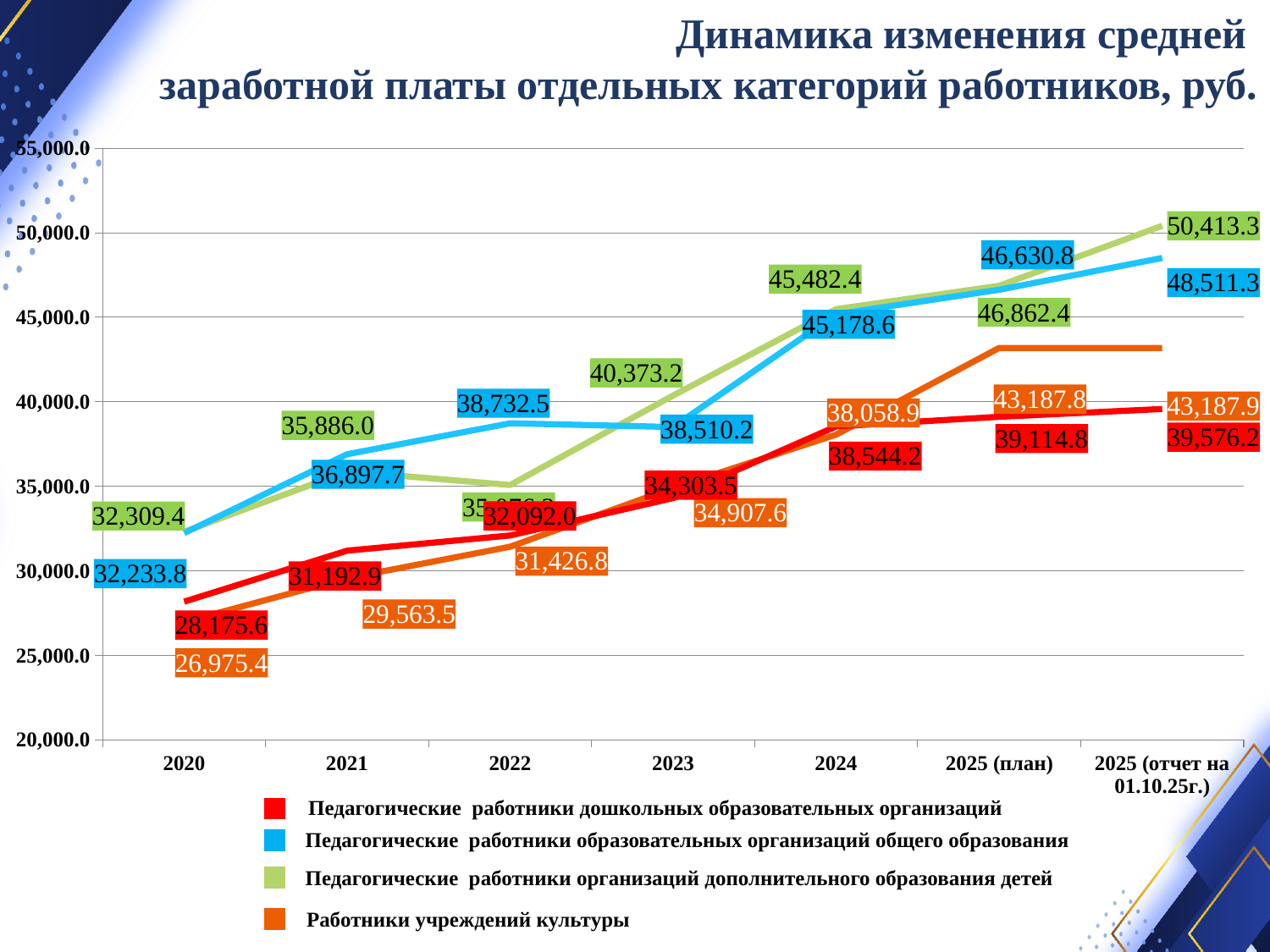
What kind of chart is shown on the slide? Line chart How many categories are shown along the x axis? 7 What is the difference between the values for Педагогические работники организаций дополнительного образования детей and Педагогические работники образовательных организаций общего образования in 2025 (отчет на 01.10.25г.)? 1,902.0 Which series has the highest value in 2025 (отчет на 01.10.25г.)? Педагогические работники организаций дополнительного образования детей How many series does the legend list? 4 Which series has the lowest value in 2020? Работники учреждений культуры What is the value for Педагогические работники образовательных организаций общего образования in 2022? 38,732.5 What is the value for Педагогические работники дошкольных образовательных организаций in 2025 (отчет на 01.10.25г.)? 39,576.2 What is the value for Педагогические работники организаций дополнительного образования детей in 2020? 32,309.4 In 2021, which is larger: the value for Педагогические работники образовательных организаций общего образования or for Педагогические работники организаций дополнительного образования детей? Педагогические работники образовательных организаций общего образования What is the value for Работники учреждений культуры in 2023? 34,907.6 Does the line for Педагогические работники дошкольных образовательных организаций rise or fall from 2020 to 2025 (отчет на 01.10.25г.)? Rise